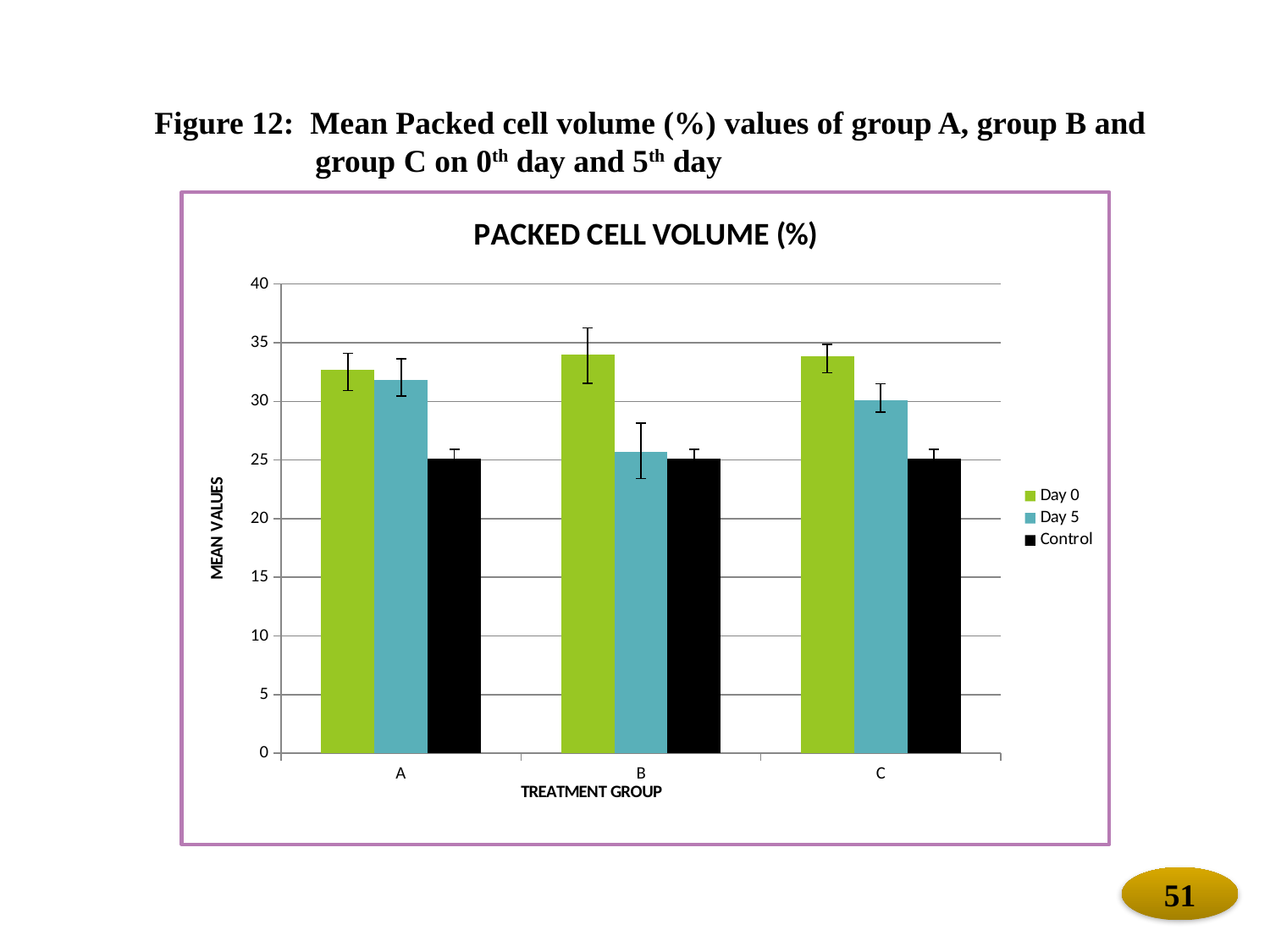
What is the label of the y axis? MEAN VALUES Which treatment group has the lowest Day 5 value? B Is the Day 0 value for group B greater or less than 30? greater For group A, which is larger, the Day 0 value or the Control value? Day 0 How many series does the legend list? 3 For group B, which is larger, the Day 0 value or the Day 5 value? Day 0 How many treatment groups are shown on the x axis? 3 Is the Day 5 value for group C greater or less than 25? greater What kind of chart is shown on the slide? bar chart Is the Day 0 value for group A greater or less than 30? greater What is the title of the chart? PACKED CELL VOLUME (%)